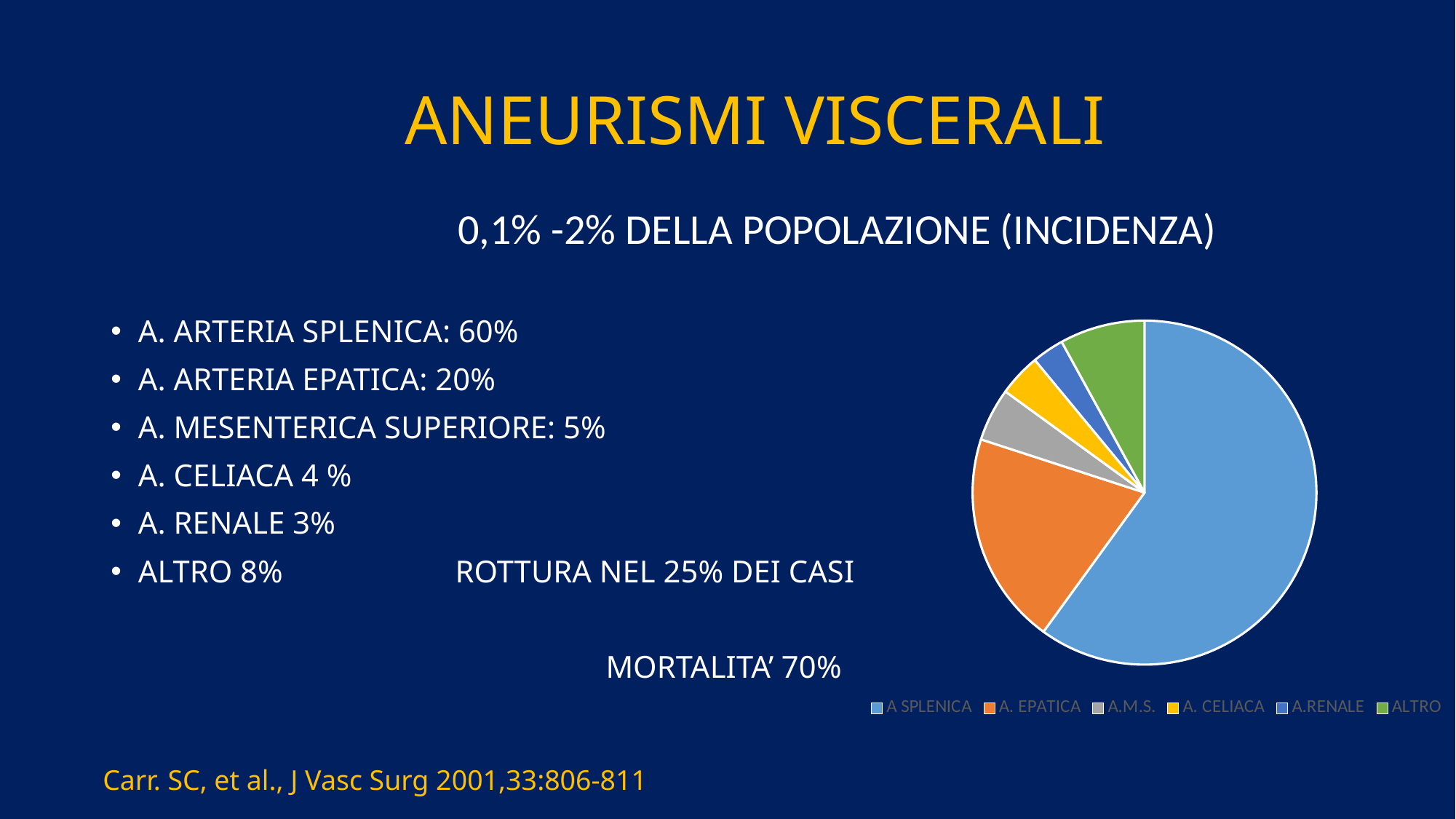
How many slices does the pie chart have? 6 What kind of chart is shown on the slide? pie chart Which slice of the pie chart is the smallest? A.RENALE How many entries does the pie chart's legend list? 6 What share of the pie chart does A SPLENICA represent? 60% What colour is the A SPLENICA slice in the pie chart? light blue What is the difference between the A SPLENICA share and the A. EPATICA share in the pie chart? 40% Which is larger in the pie chart, A. EPATICA or A.M.S.? A. EPATICA Which slice of the pie chart is the largest? A SPLENICA What share of the pie chart does ALTRO represent? 8% Which is larger in the pie chart, ALTRO or A.M.S.? ALTRO Is the A SPLENICA slice greater or less than half of the pie chart? greater